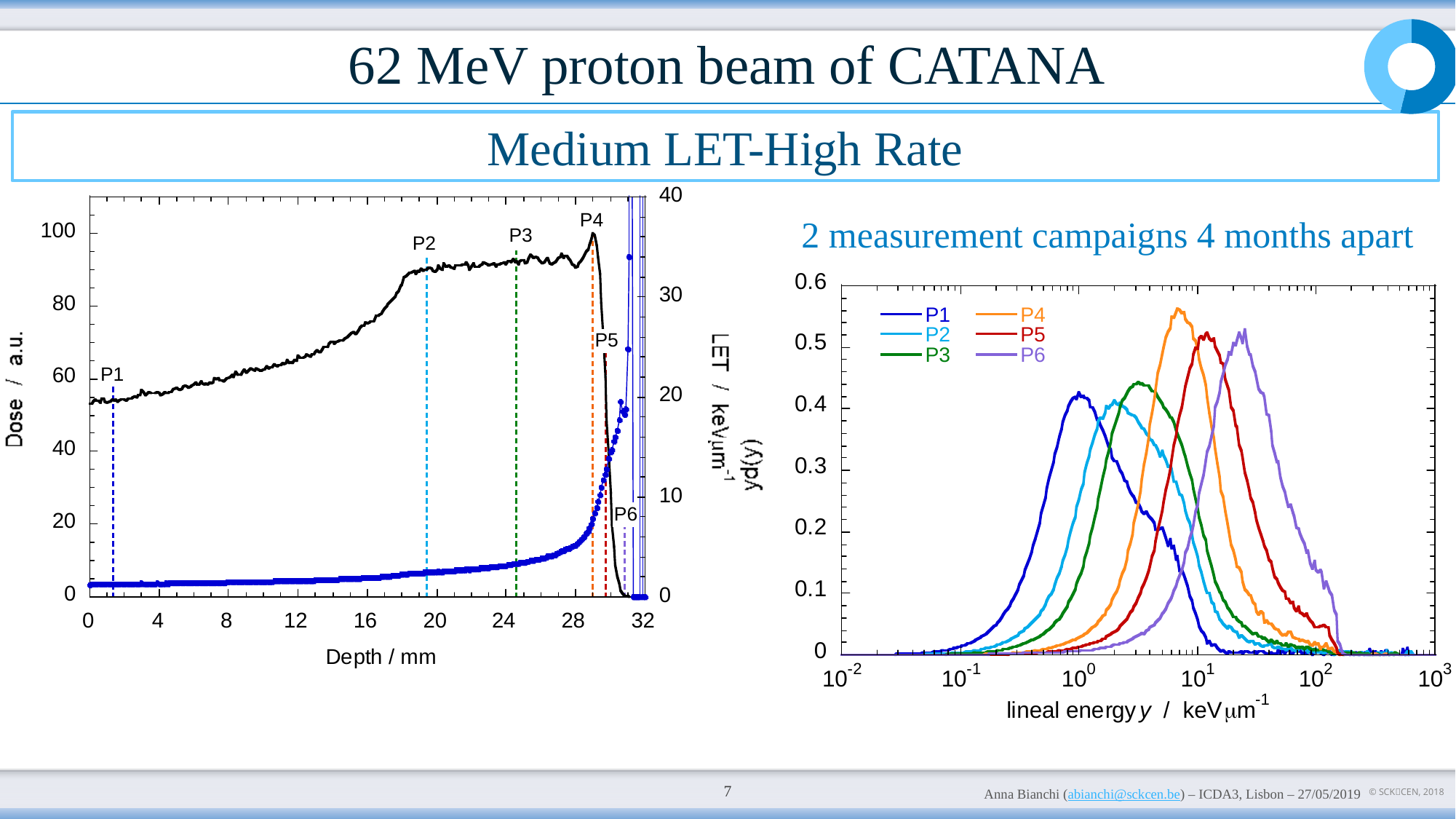
In the left-hand chart, how many labelled positions (P1 to P6) are marked with dashed vertical lines? 6 What kind of chart is the right-hand chart of yd(y) versus lineal energy? line chart In the left-hand chart, at which labelled position does the dose curve reach its maximum? P4 In the right-hand chart, what colour is the P6 curve? purple How many series does the legend of the right-hand chart list? 6 In the left-hand chart, is the dose at P1 greater or less than 40? greater In the right-hand chart, which series has the higher peak, P4 or P1? P4 In the right-hand chart, is the peak of P1 greater or less than 0.5? less In the right-hand chart, which series has its peak at the highest lineal energy? P6 In the right-hand chart, which series has its peak at the lowest lineal energy? P1 In the right-hand chart, is the peak of P6 greater or less than 0.5? greater In the right-hand chart, which series reaches the highest peak value of yd(y)? P4